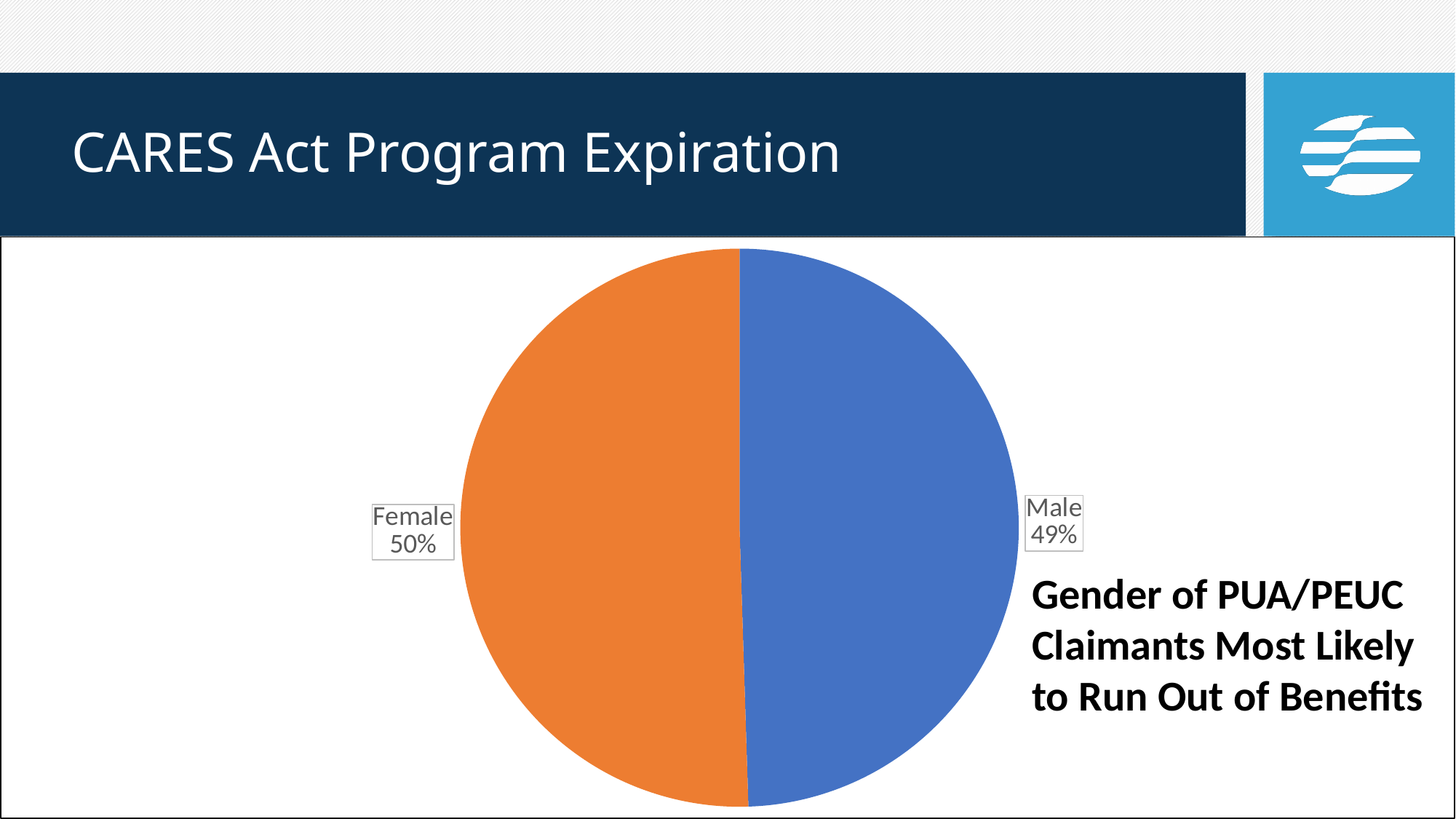
What colour is the Male slice of the pie chart? blue Which category has the larger share of the pie? Female What share of the pie does the Female slice represent? 50% Is the Female share larger or smaller than the Male share? larger What kind of chart is shown on the slide? pie chart How many slices does the pie chart have? 2 What is the value shown for Female? 50% Which category has the smaller share of the pie? Male What is the title of the pie chart? Gender of PUA/PEUC Claimants Most Likely to Run Out of Benefits What share of the pie does the Male slice represent? 49% What is the difference between the Female and Male percentages? 1% What is the value shown for Male? 49%